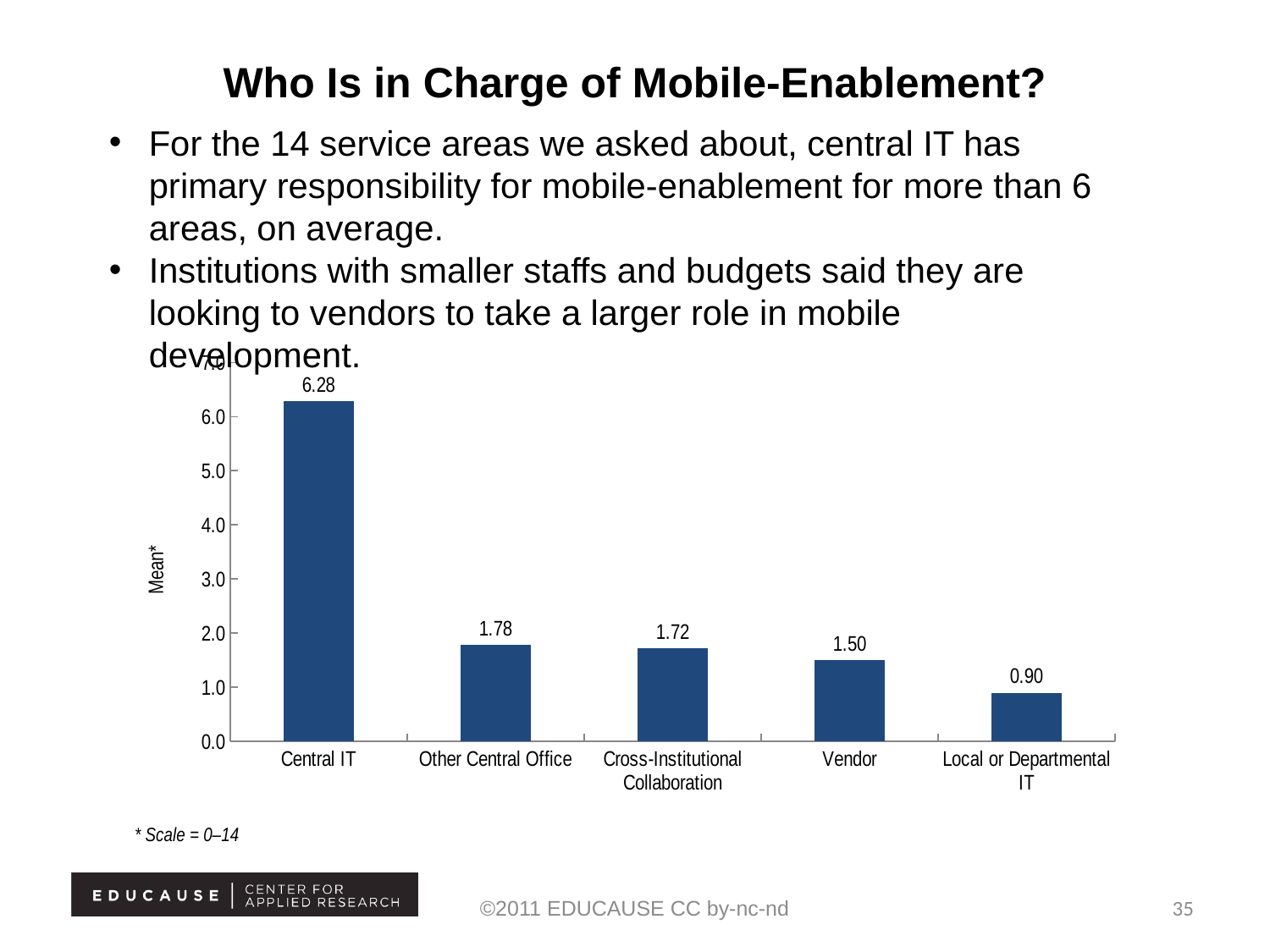
What is the mean value for Central IT? 6.28 Which category has the lowest mean? Local or Departmental IT What kind of chart is shown on the slide? Bar chart What is the difference between the mean for Vendor and the mean for Local or Departmental IT? 0.60 What is the mean value for Vendor? 1.50 How many categories are shown on the x axis? 5 Which category has the highest mean? Central IT What is the difference between the mean for Central IT and the mean for Other Central Office? 4.50 What is the mean value for Cross-Institutional Collaboration? 1.72 What is the mean value for Local or Departmental IT? 0.90 What is the label of the y axis? Mean* Which has a larger mean, Central IT or Vendor? Central IT